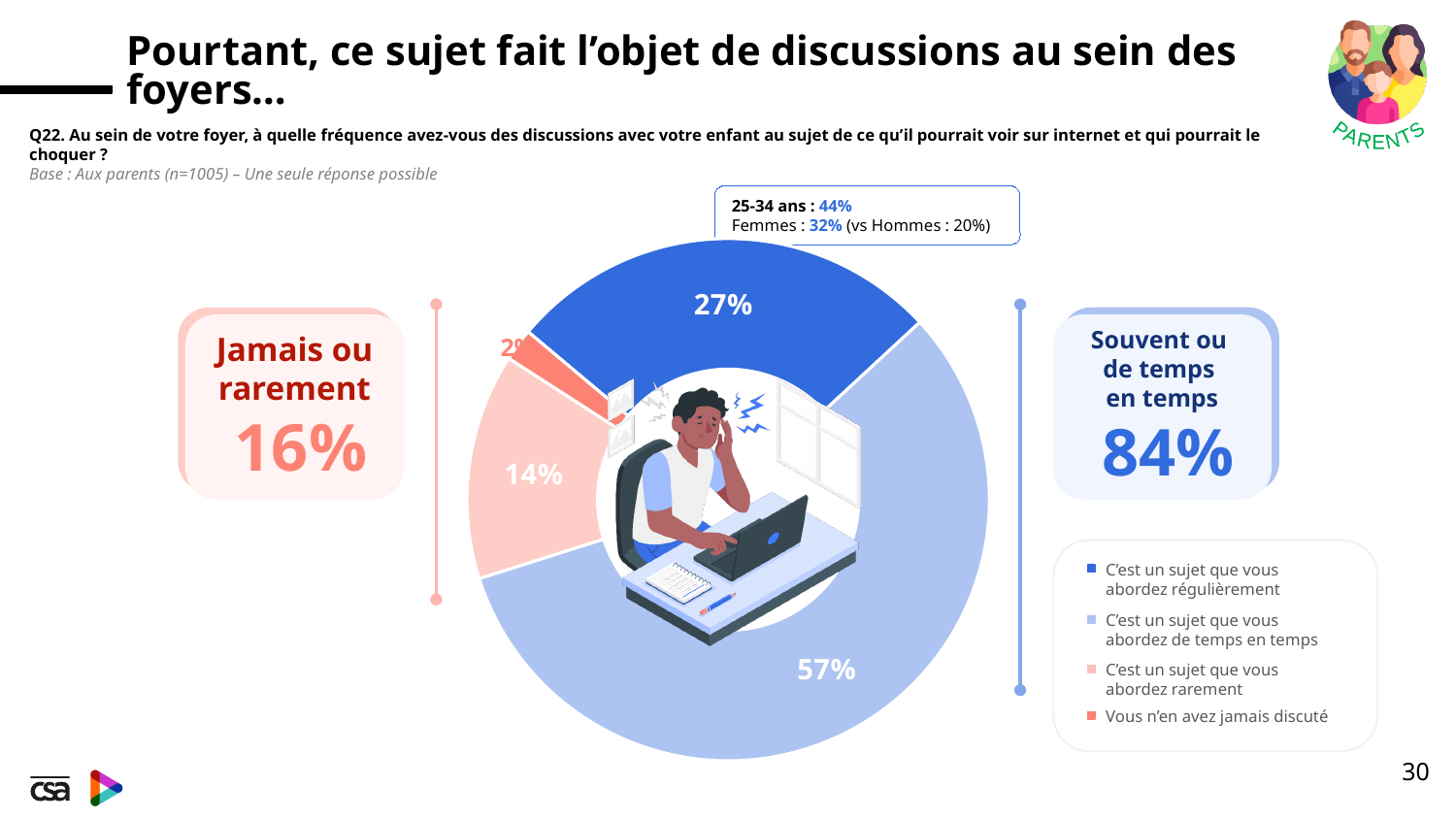
What percentage of parents say it is a subject they discuss rarely ("rarement")? 14% Which response has the largest share of the pie? C'est un sujet que vous abordez de temps en temps What percentage of parents say it is a subject they discuss regularly ("régulièrement")? 27% According to the annotation, what percentage of 25-34 year olds discuss the subject regularly? 44% What type of chart is used on this slide? Doughnut chart What combined percentage is shown in the callout for "Souvent ou de temps en temps"? 84% What percentage of parents say it is a subject they discuss from time to time ("de temps en temps")? 57% What is the difference in percentage points between parents who discuss the subject from time to time and those who discuss it regularly? 30 What combined percentage is shown in the callout for "Jamais ou rarement"? 16% Which is larger: the share of parents who discuss the subject regularly or the share who discuss it rarely? Regularly (27%) Which response has the smallest share of the pie? Vous n'en avez jamais discuté How many response categories does the legend list? 4